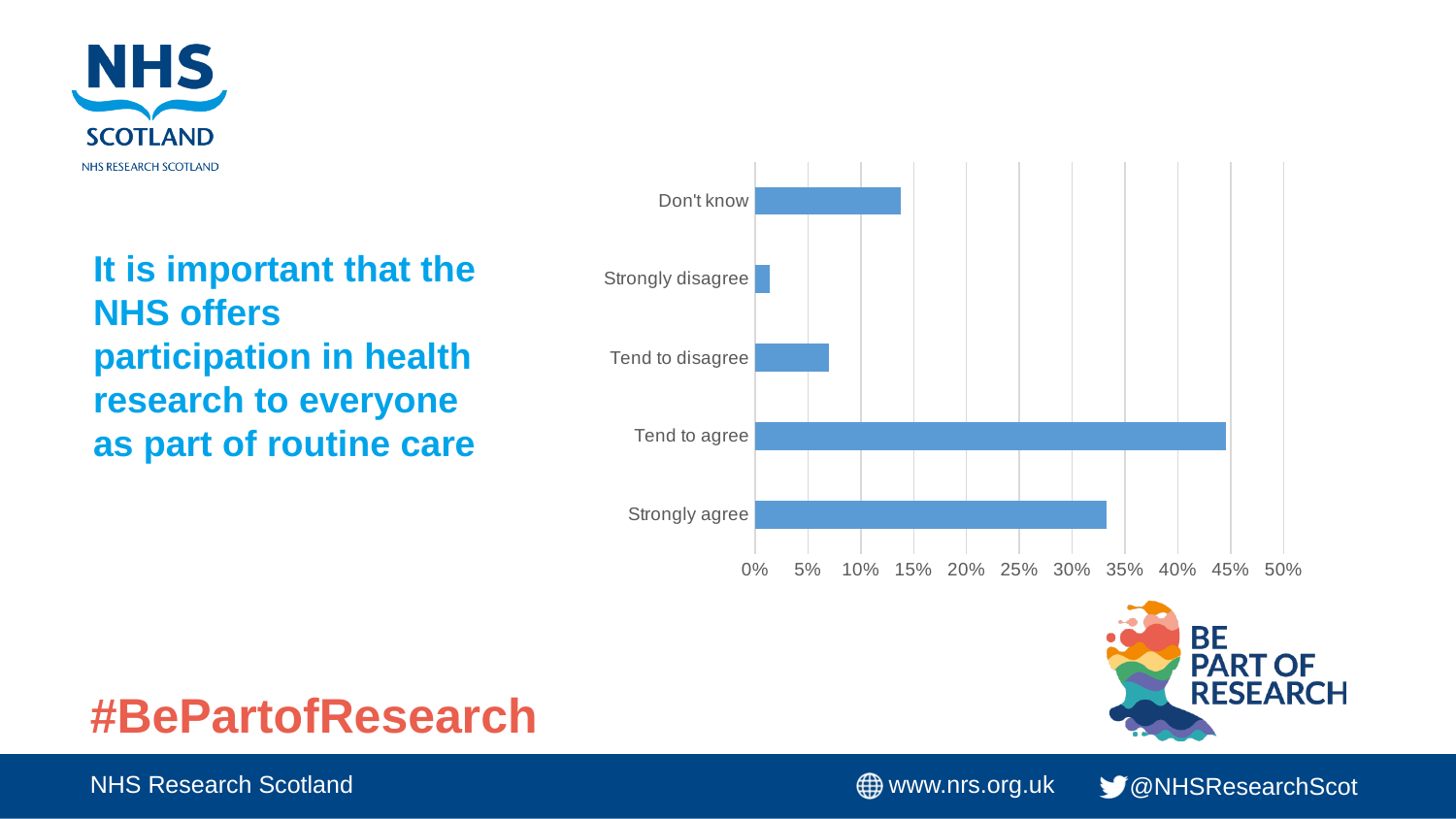
Which is larger, the value for Tend to disagree or the value for Don't know? Don't know What kind of chart is shown on the slide? bar chart How many categories are plotted on the chart? 5 Which is larger, the value for Strongly agree or the value for Don't know? Strongly agree Is the value for Strongly agree greater or less than 30%? greater Is the value for Tend to agree greater or less than 40%? greater Is the value for Don't know greater or less than 15%? less Which category has the lowest value? Strongly disagree What is the highest value shown on the chart's horizontal axis? 50% Which category has the highest value? Tend to agree